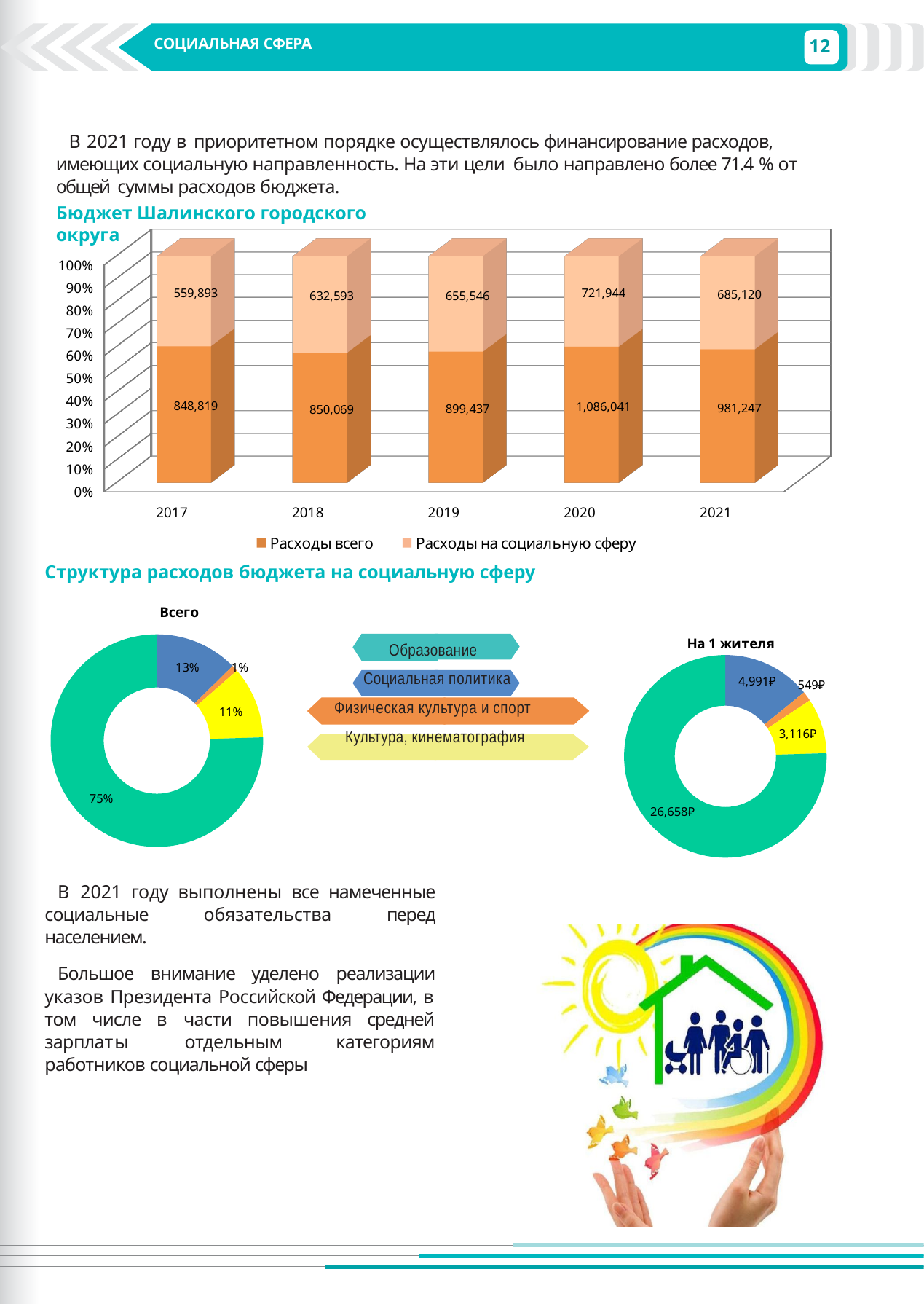
In the chart 'Бюджет Шалинского городского округа', how many years are shown on the x axis? 5 In the chart 'Бюджет Шалинского городского округа', how many series does the legend list? 2 In the chart 'Бюджет Шалинского городского округа', what is the value of 'Расходы на социальную сферу' for 2017? 559,893 In the chart 'Бюджет Шалинского городского округа', what is the difference between 'Расходы всего' in 2021 and in 2019? 81,810 In the donut chart 'На 1 жителя', what is the value for the yellow segment (Культура, кинематография)? 3,116₽ In the chart 'Бюджет Шалинского городского округа', which year has the lowest value of 'Расходы на социальную сферу'? 2017 In the donut chart 'На 1 жителя', which is larger: the value for Социальная политика or the value for Культура, кинематография? Социальная политика In the chart 'Бюджет Шалинского городского округа', which year has the highest value of 'Расходы всего'? 2020 In the chart 'Бюджет Шалинского городского округа', what is the value of 'Расходы всего' for 2020? 1,086,041 In the donut chart 'Всего', which category has the smallest share? Физическая культура и спорт What type of chart is 'Бюджет Шалинского городского округа'? Stacked bar chart In the donut chart 'Всего', what share does the green segment (Образование) have? 75%